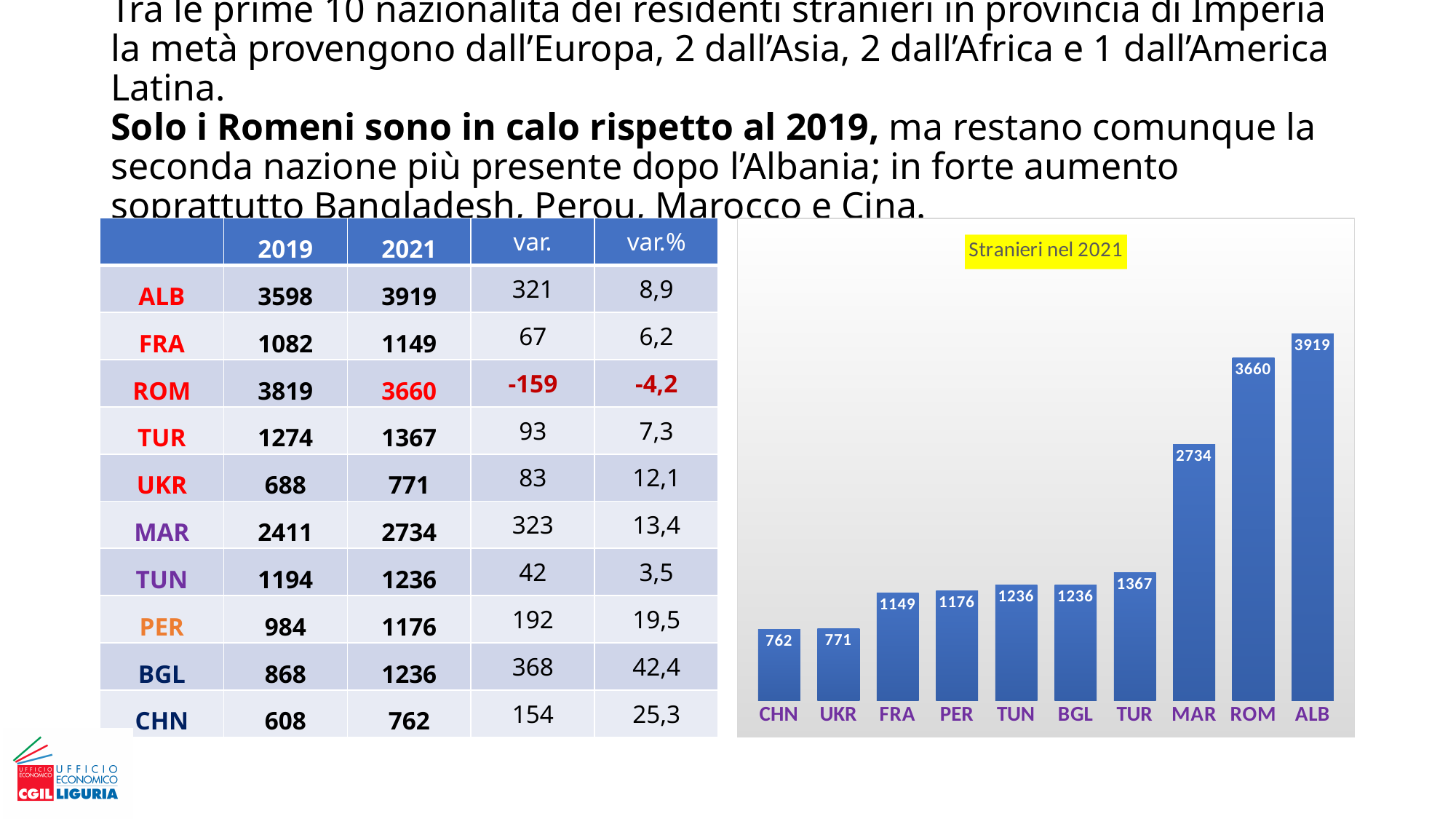
What is the value for ALB in the 'Stranieri nel 2021' chart? 3919 What is the difference between the values for MAR and TUR in the 'Stranieri nel 2021' chart? 1367 How many categories are shown in the 'Stranieri nel 2021' chart? 10 Do the values in the 'Stranieri nel 2021' chart rise or fall from left to right along the x axis? Rise What is the value for CHN in the 'Stranieri nel 2021' chart? 762 What kind of chart is the 'Stranieri nel 2021' chart? Bar chart What is the value for MAR in the 'Stranieri nel 2021' chart? 2734 Which is larger in the 'Stranieri nel 2021' chart, the value for FRA or the value for PER? PER Which category has the lowest value in the 'Stranieri nel 2021' chart? CHN Which category has the highest value in the 'Stranieri nel 2021' chart? ALB What is the difference between the values for ALB and ROM in the 'Stranieri nel 2021' chart? 259 Which is larger in the 'Stranieri nel 2021' chart, the value for ROM or the value for MAR? ROM